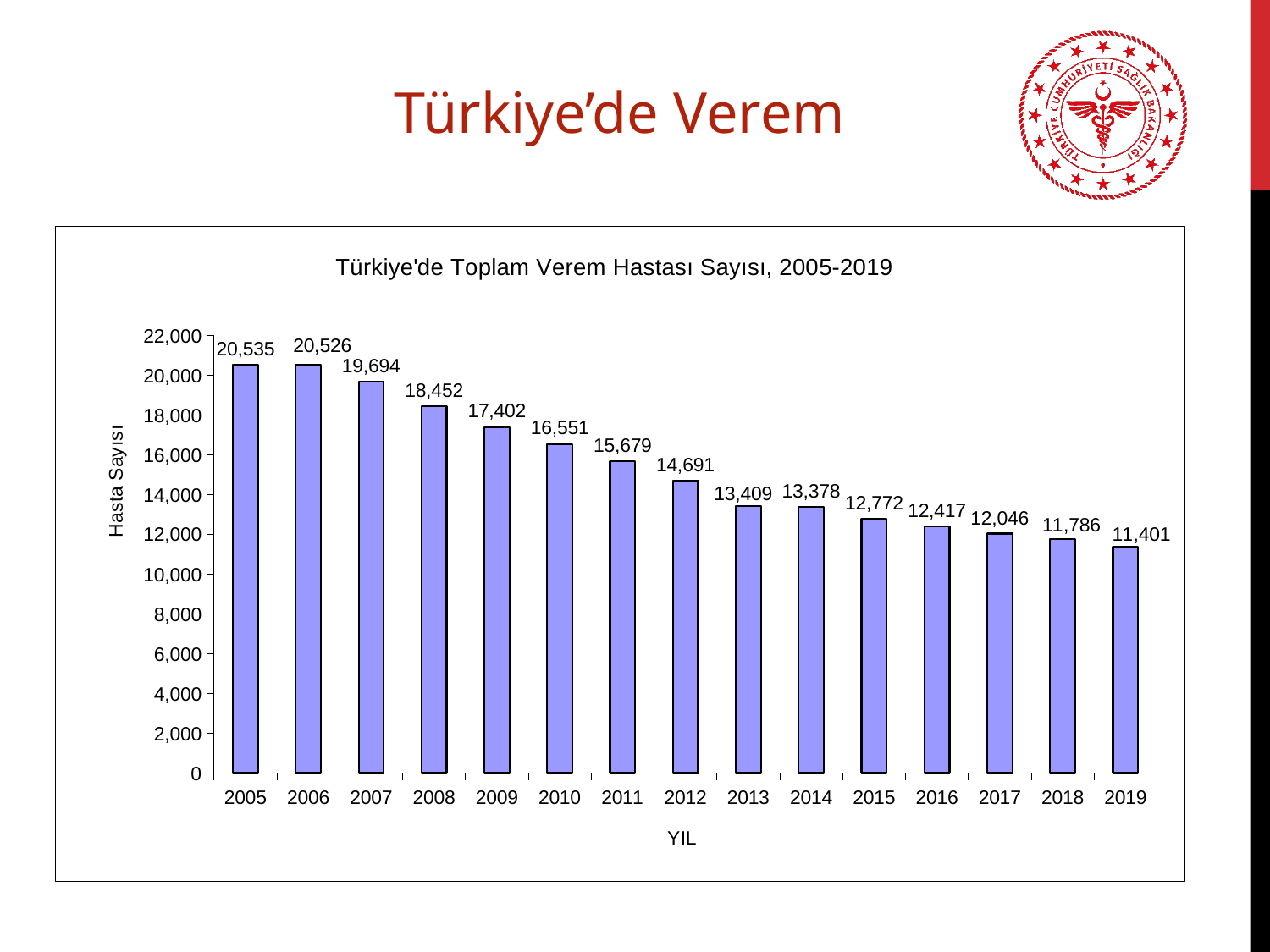
Is the value for 2011 greater or less than 14,000? greater What is the difference between the values for 2008 and 2009? 1,050 Which year has the lowest number of patients? 2019 Which is larger, the value for 2010 or the value for 2015? 2010 How many years are shown on the x axis? 15 Which year has the highest number of patients? 2005 What kind of chart is this? bar chart What is the value for 2012? 14,691 Do the values rise or fall from 2005 to 2019? fall What is the value for 2005? 20,535 What is the difference between the values for 2005 and 2019? 9,134 What is the value for 2019? 11,401